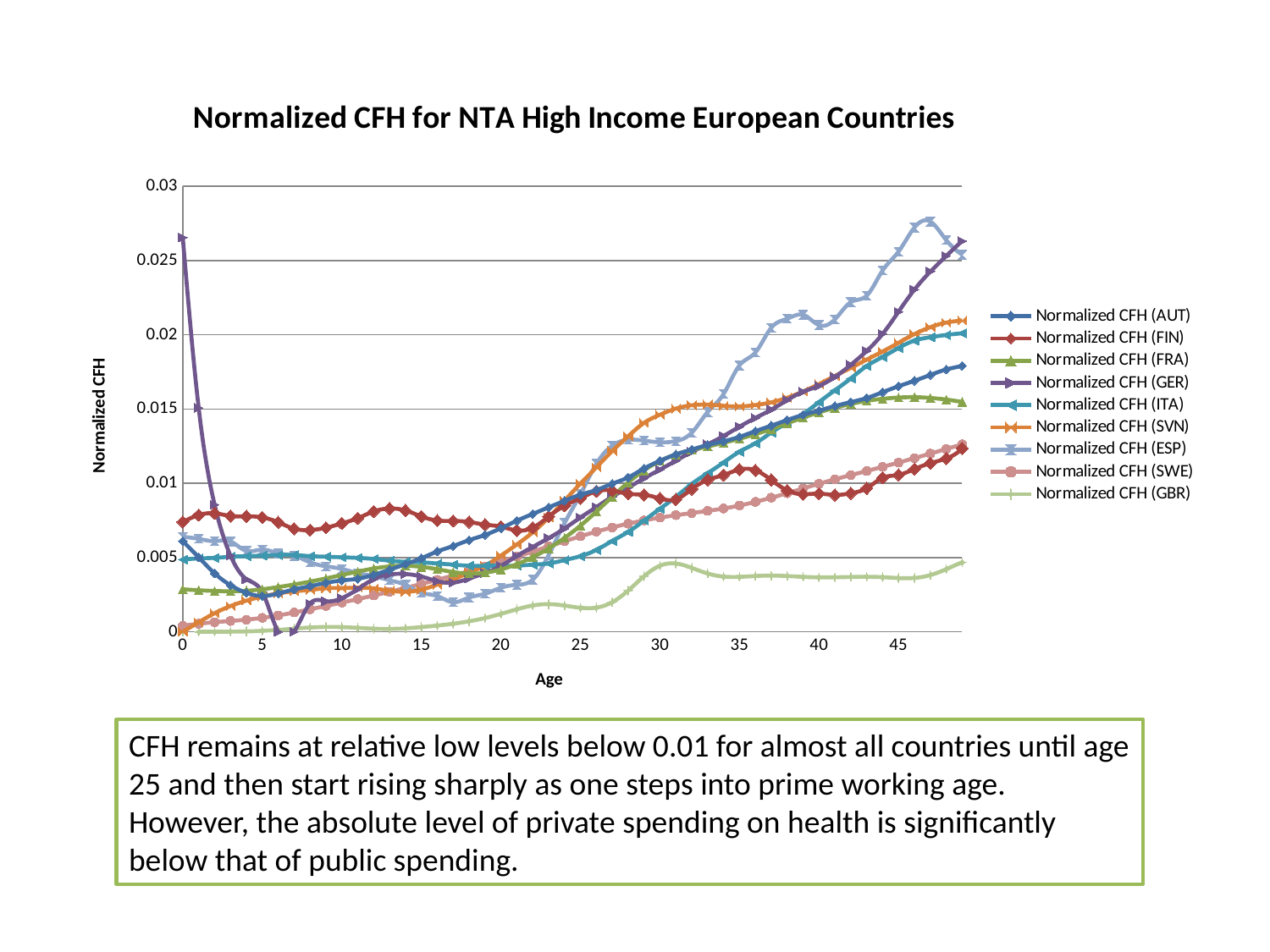
Does the Normalized CFH (SWE) series rise or fall as age increases? rises Which series has the highest value at age 0? Normalized CFH (GER) What kind of chart is shown on the slide? line chart Is the value for Normalized CFH (FIN) at age 0 greater or less than 0.005? greater What is the title of the chart? Normalized CFH for NTA High Income European Countries At age 45, which is larger: Normalized CFH (SVN) or Normalized CFH (FRA)? Normalized CFH (SVN) What is the label of the x axis? Age How many series does the legend list? 9 Is the value for Normalized CFH (GBR) at age 20 greater or less than 0.005? less Which series has the lowest value at age 45? Normalized CFH (GBR) Is the value for Normalized CFH (ITA) at age 45 greater or less than 0.015? greater